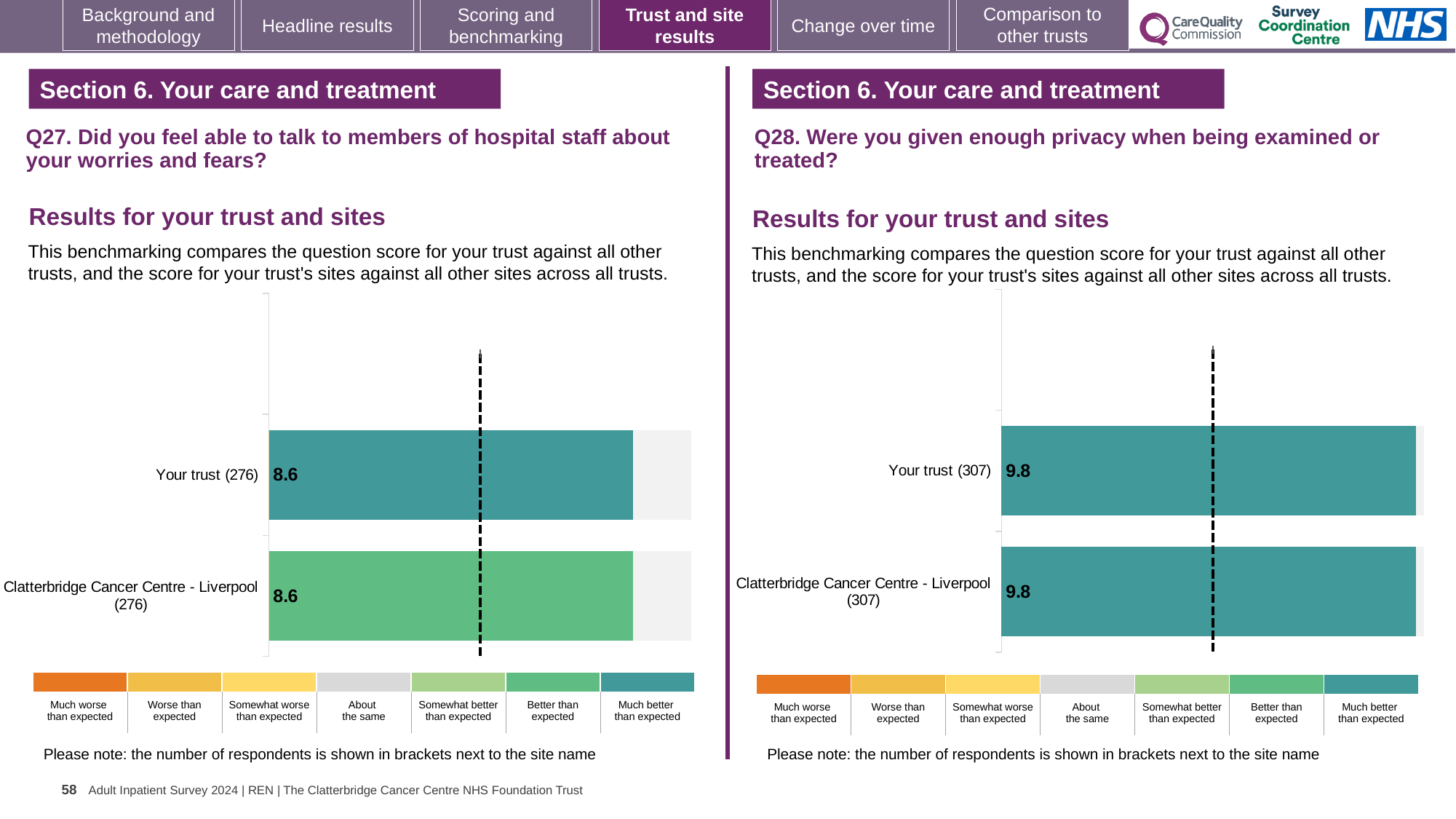
What kind of chart is the Q27 chart on the left? Bar chart How many categories does the colour key below the Q27 chart on the left list? 7 In the Q27 chart on the left, what is the score for Clatterbridge Cancer Centre - Liverpool (276)? 8.6 How many bars are plotted in the Q27 chart on the left? 2 In the Q28 chart on the right, what is the score for Your trust (307)? 9.8 In the Q27 chart on the left, what colour is the bar for Clatterbridge Cancer Centre - Liverpool (276)? Green In the Q28 chart on the right, is the score for Your trust larger than, smaller than, or the same as the score for Clatterbridge Cancer Centre - Liverpool? the same In the Q28 chart on the right, what is the score for Clatterbridge Cancer Centre - Liverpool (307)? 9.8 How many bars are plotted in the Q28 chart on the right? 2 In the Q27 chart on the left, what is the score for Your trust (276)? 8.6 In the Q27 chart on the left, what is the difference between the score for Your trust and the score for Clatterbridge Cancer Centre - Liverpool? 0 How many respondents are shown in brackets for Your trust in the Q28 chart on the right? 307